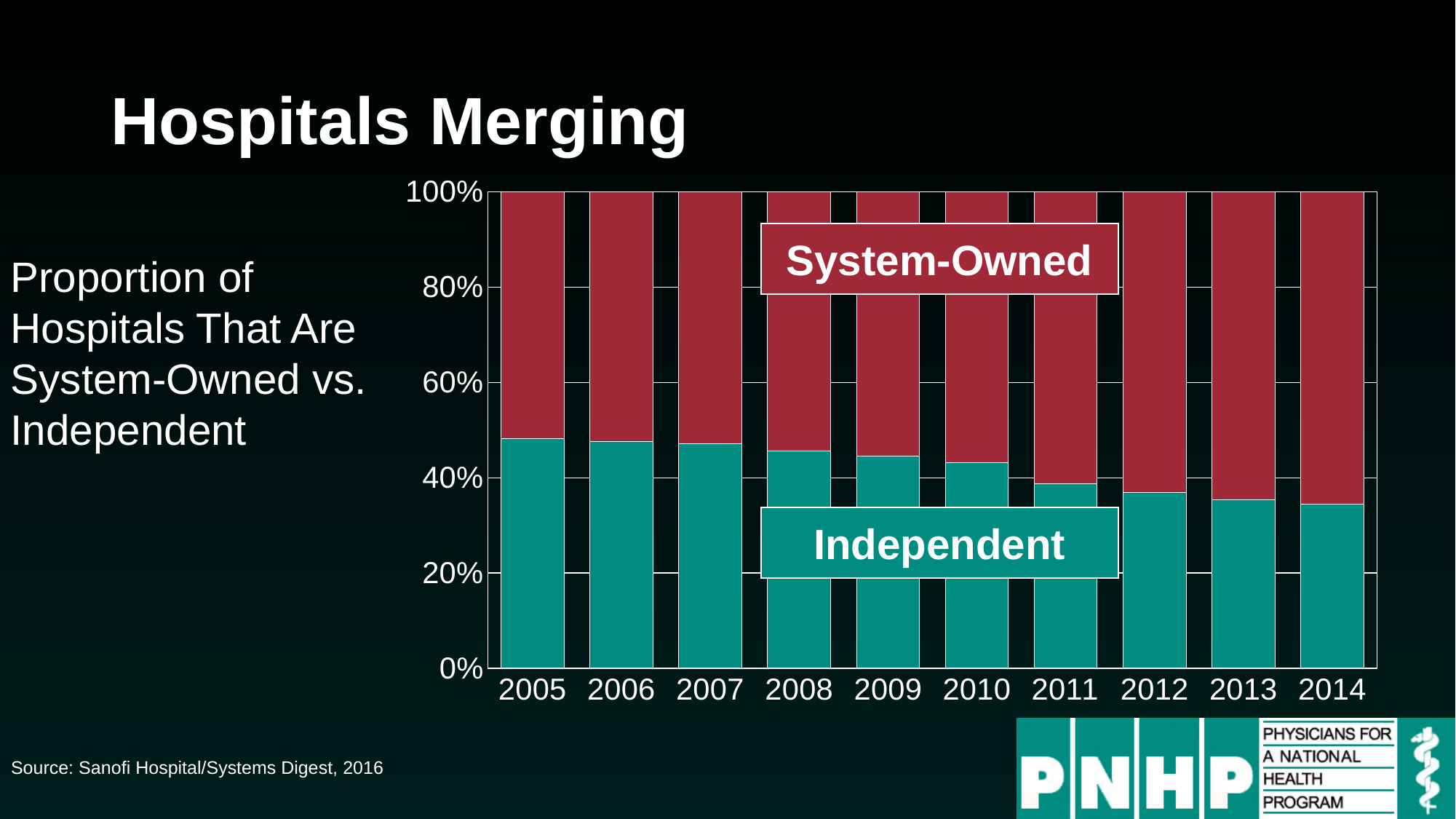
How many years are shown along the x axis of the chart? 10 Does the Independent share rise or fall from 2005 to 2014? Fall Which two series are labelled on the chart? System-Owned and Independent What is the total of each stacked bar in the chart? 100% How many series does the chart show? 2 What kind of chart is shown on the slide? Stacked bar chart Is the Independent share in 2014 greater or less than 40%? less Is the Independent share in 2008 greater or less than 40%? greater What is the title of the slide containing the chart? Hospitals Merging Is the System-Owned share in 2014 greater or less than 60%? greater Does the System-Owned share rise or fall from 2005 to 2014? Rise Which year has the larger Independent share, 2005 or 2014? 2005